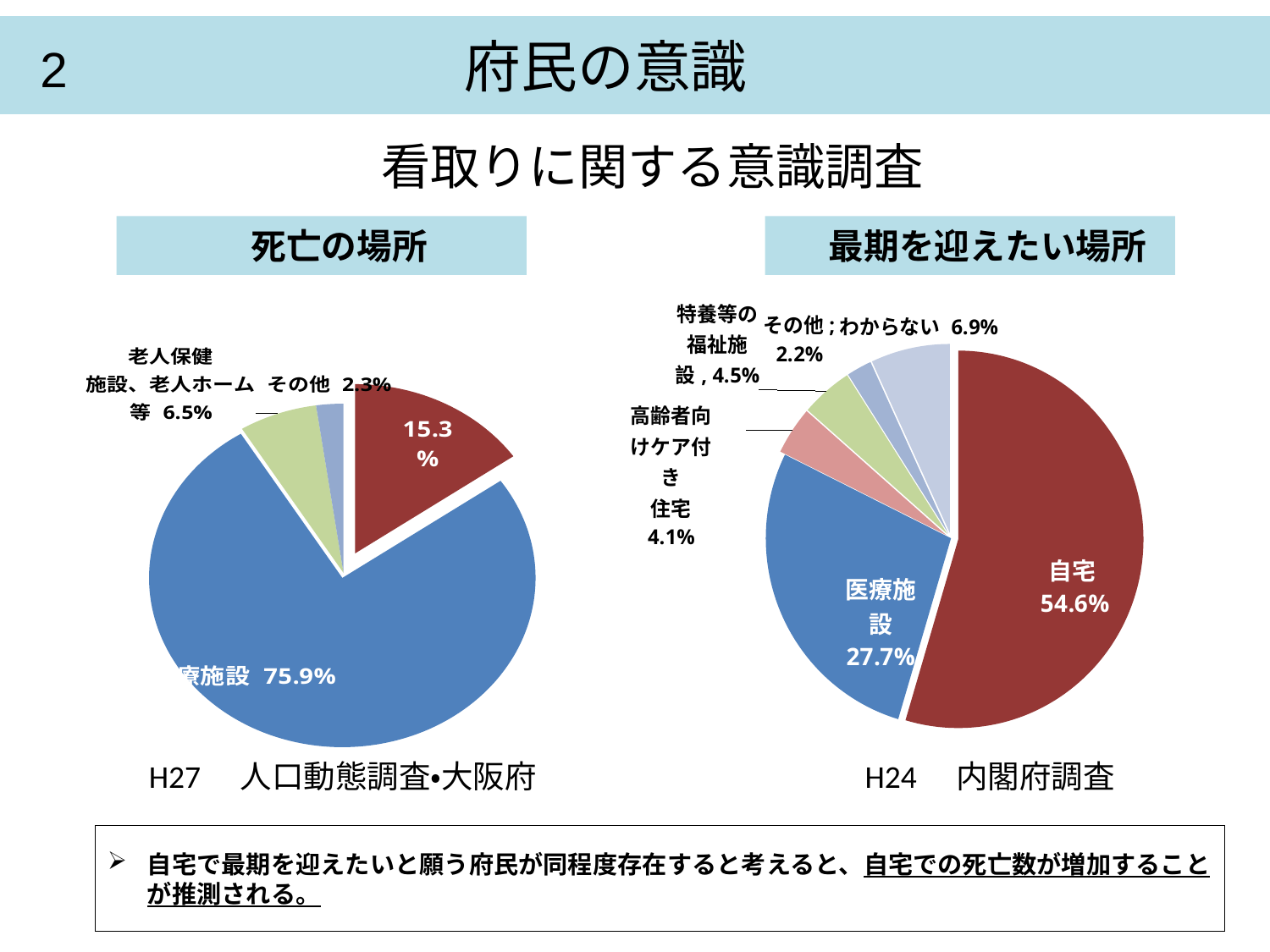
In the 最期を迎えたい場所 chart on the right, which is larger: 特養等の福祉施設 or 高齢者向けケア付き住宅? 特養等の福祉施設 In the 死亡の場所 chart on the left, what percentage is shown for 老人保健施設、老人ホーム等? 6.5% In the 最期を迎えたい場所 chart on the right, what percentage is shown for その他;わからない? 6.9% In the 最期を迎えたい場所 chart on the right, which category has the largest share? 自宅 How many slices does the 死亡の場所 pie chart on the left have? 4 In the 死亡の場所 chart on the left, what percentage is shown for その他? 2.3% In the 死亡の場所 chart on the left, what percentage is shown for 医療施設? 75.9% In the 最期を迎えたい場所 chart on the right, what is the difference in percentage points between 自宅 and 医療施設? 26.9 percentage points In the 死亡の場所 chart on the left, which category has the largest share? 医療施設 In the 最期を迎えたい場所 chart on the right, what percentage is shown for 医療施設? 27.7% What kind of chart is the 死亡の場所 chart on the left? pie chart In the 最期を迎えたい場所 chart on the right, what percentage is shown for 自宅? 54.6%